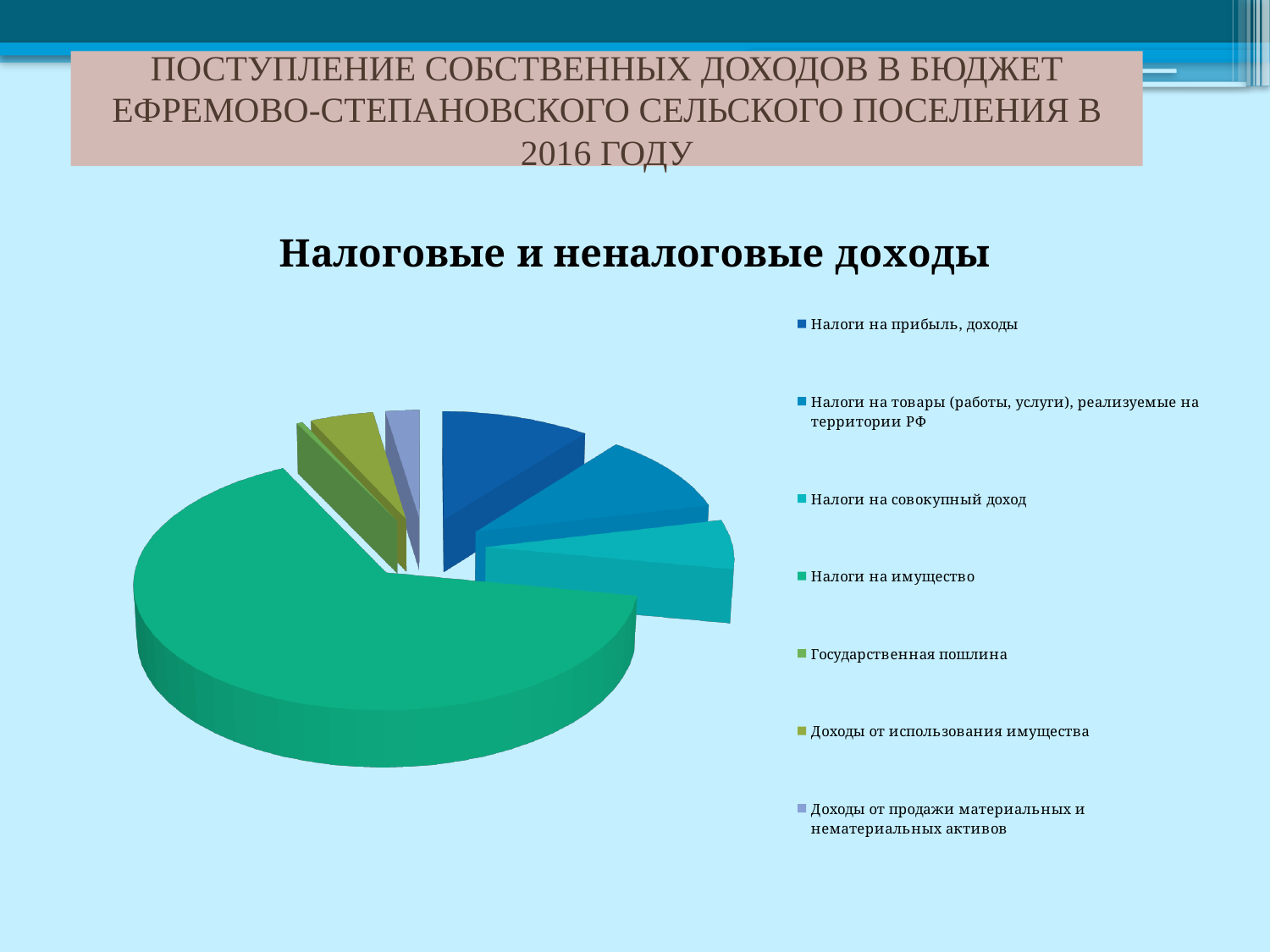
Which is larger: the slice for Налоги на имущество or the slice for Налоги на прибыль, доходы? Налоги на имущество How many entries does the legend list? 7 Which is larger: the slice for Налоги на товары (работы, услуги), реализуемые на территории РФ or the slice for Доходы от продажи материальных и нематериальных активов? Налоги на товары (работы, услуги), реализуемые на территории РФ What is the title of the chart? Налоговые и неналоговые доходы Which legend entry is listed first? Налоги на прибыль, доходы Which category has the largest slice of the pie? Налоги на имущество Which is larger: the slice for Налоги на прибыль, доходы or the slice for Государственная пошлина? Налоги на прибыль, доходы What kind of chart is shown on the slide? Pie chart How many categories (slices) does the pie chart have? 7 What colour is the slice for Налоги на имущество? Green